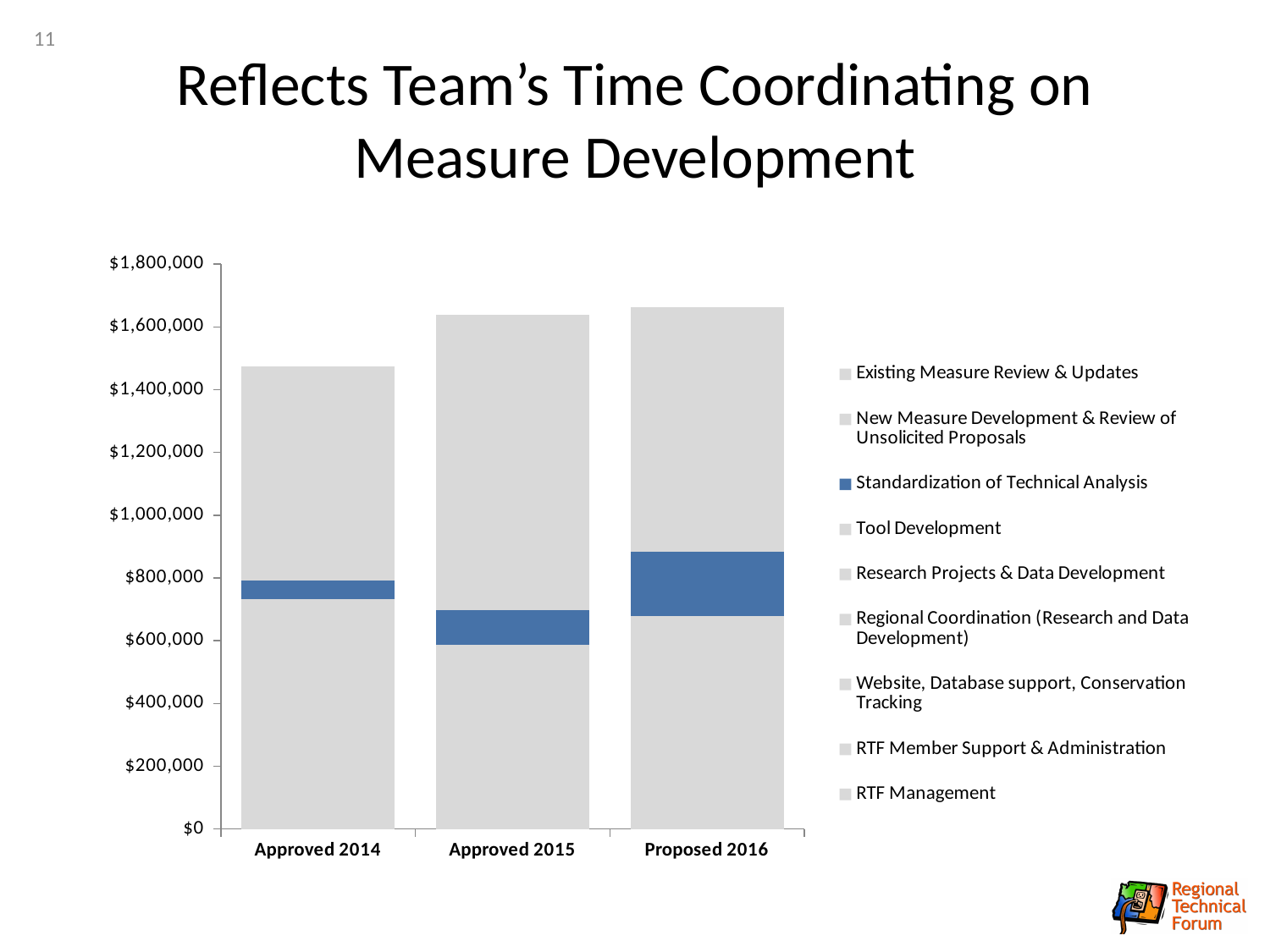
How many categories are shown along the x axis of the chart? 3 Is the total for Approved 2015 greater or less than $1,400,000? greater What kind of chart is shown on the slide? Stacked bar chart Which category has the largest Standardization of Technical Analysis segment? Proposed 2016 Which category has the lowest total bar height? Approved 2014 Which has the larger total, Approved 2014 or Approved 2015? Approved 2015 How many series does the chart's legend list? 9 Do the total bar heights rise or fall from Approved 2014 to Proposed 2016? rise Is the total for Approved 2014 greater or less than $1,400,000? greater Is the total for Proposed 2016 greater or less than $1,600,000? greater Which legend series is highlighted in blue in the chart? Standardization of Technical Analysis Which category has the smallest Standardization of Technical Analysis segment? Approved 2014